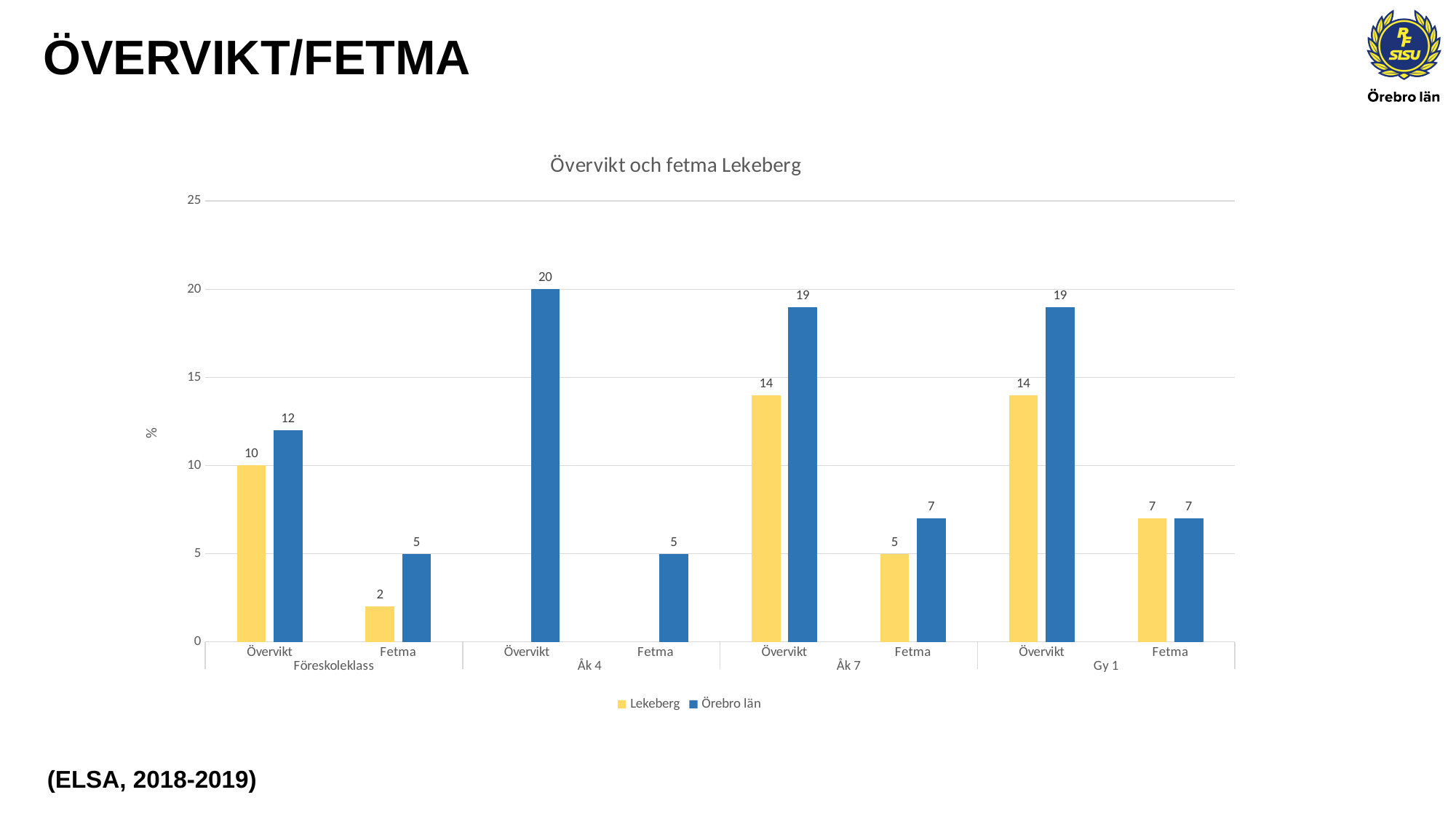
How many series does the legend list? 2 Which group and category has the highest Örebro län value? Övervikt, Åk 4 Which is larger for Övervikt in Föreskoleklass: Lekeberg or Örebro län? Örebro län What is the value for Lekeberg for Fetma in Föreskoleklass? 2 What is the value for Lekeberg for Övervikt in Föreskoleklass? 10 What colour represents Lekeberg in the chart? Yellow What is the difference between Örebro län and Lekeberg for Övervikt in Åk 7? 5 What kind of chart is shown? Bar chart What is the value for Örebro län for Övervikt in Åk 4? 20 What is the value for Örebro län for Fetma in Åk 7? 7 Is the Örebro län value for Övervikt in Gy 1 greater or less than 15? greater What is the title of the chart? Övervikt och fetma Lekeberg